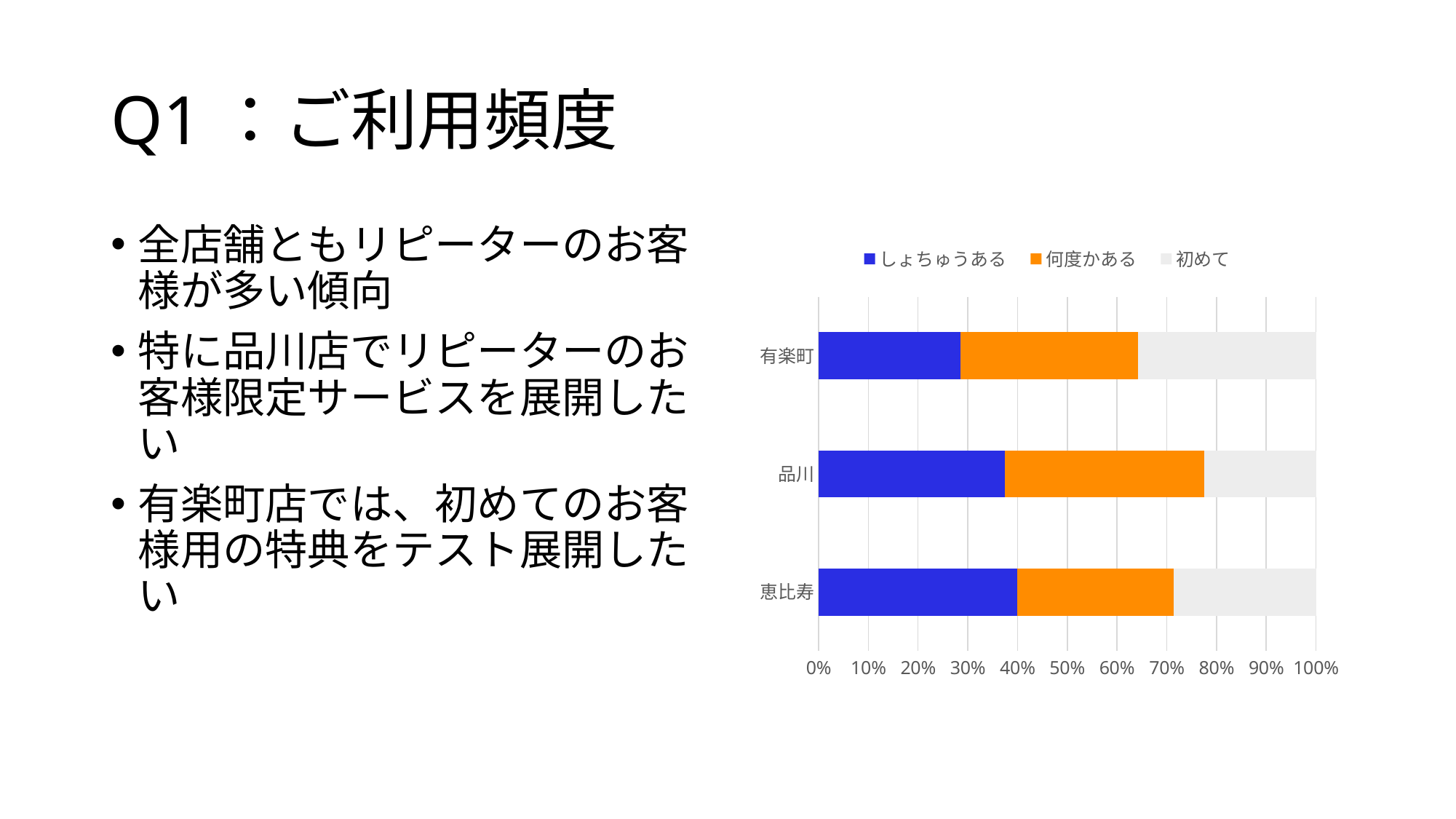
How many series does the chart legend list? 3 What is the highest value shown on the chart's horizontal axis? 100% How many stores (categories) are shown on the chart? 3 Which store has the largest 初めて segment? 有楽町 Which store has the smallest 初めて segment? 品川 Which store has a larger しょちゅうある segment, 有楽町 or 品川? 品川 Is the しょちゅうある value for 恵比寿 greater or less than 30%? greater Which colour represents the 何度かある series in the chart? Orange Which store has the smallest しょちゅうある segment? 有楽町 What kind of chart is shown on the slide? Stacked bar chart Is the しょちゅうある value for 有楽町 greater or less than 40%? less Is the しょちゅうある value for 品川 greater or less than 30%? greater